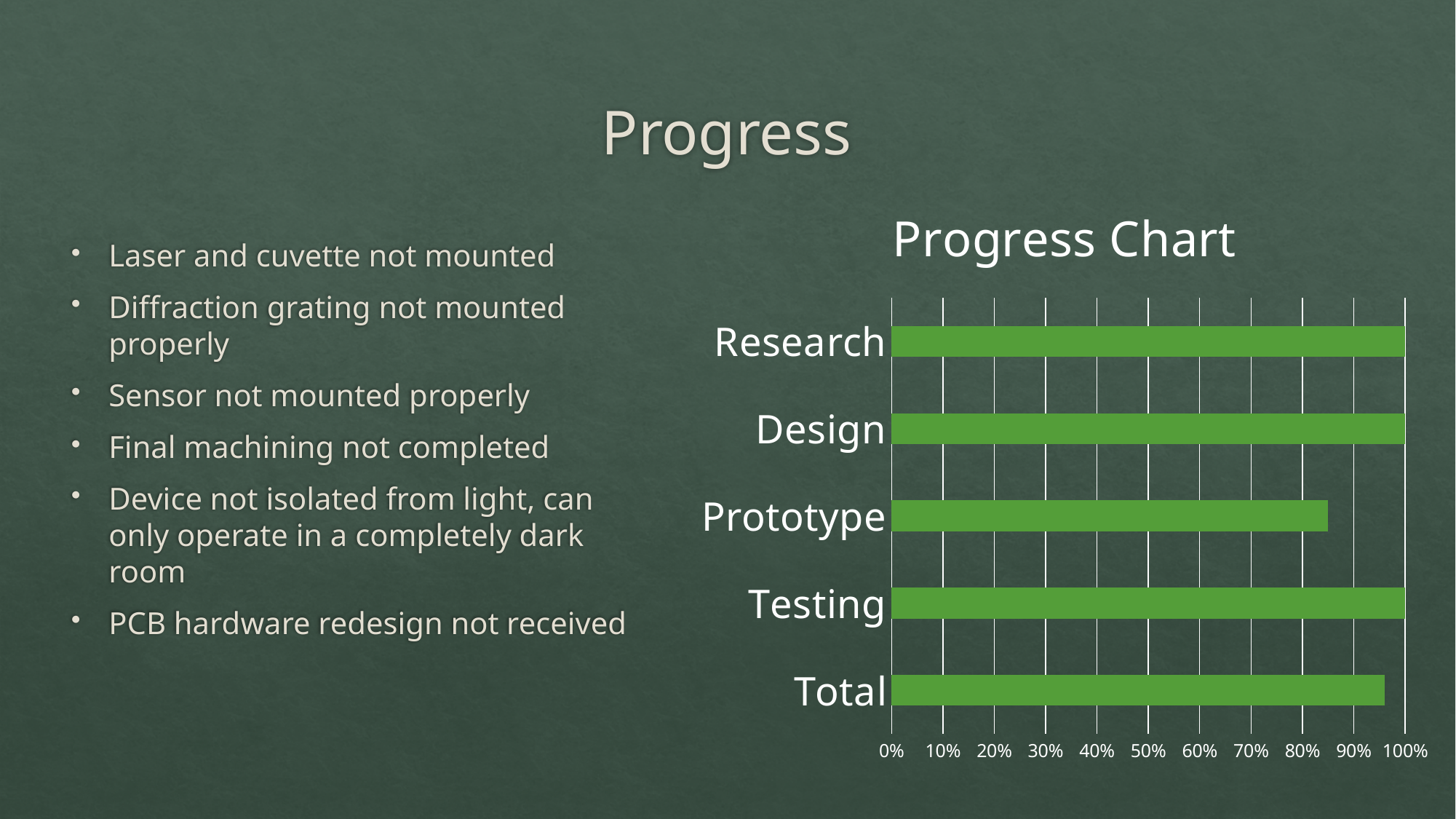
What is the title of the chart on the slide? Progress Chart What is the value for Research in the Progress Chart? 100% Which category has the lowest value in the Progress Chart? Prototype What is the value for Testing in the Progress Chart? 100% What kind of chart is the Progress Chart? bar chart Is the value for Prototype greater or less than 90%? less Is the value for Total greater or less than 90%? greater What colour are the bars in the Progress Chart? green Which is larger in the Progress Chart, Prototype or Total? Total How many categories are shown in the Progress Chart? 5 What is the value for Design in the Progress Chart? 100% Is the value for Prototype greater or less than 80%? greater